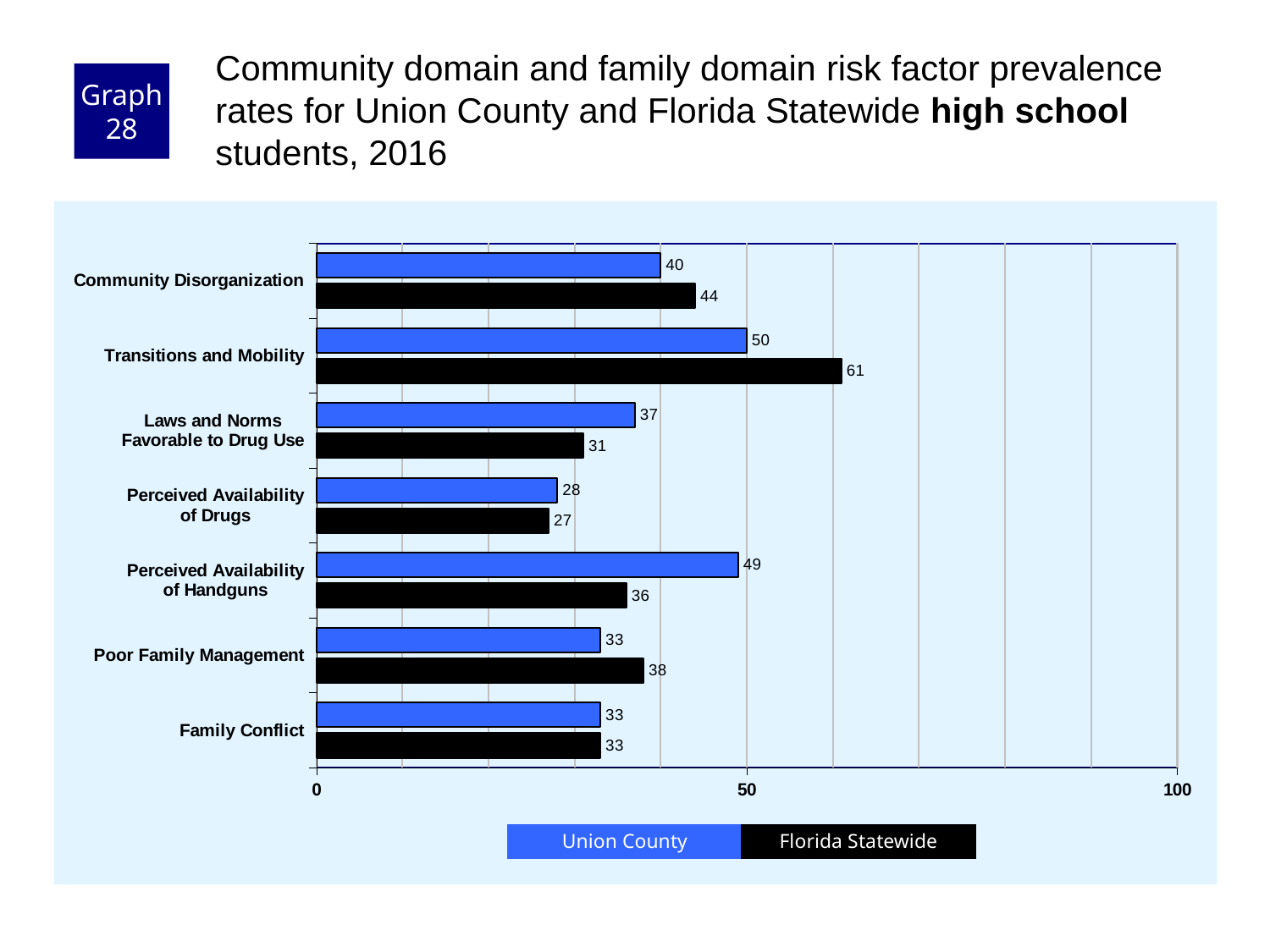
What is the difference between the Florida Statewide and Union County values for Transitions and Mobility? 11 What is the Florida Statewide value for Perceived Availability of Handguns? 36 What is the difference between the Union County and Florida Statewide values for Perceived Availability of Handguns? 13 What kind of chart is shown on the slide? bar chart Which risk factor has the lowest Union County value? Perceived Availability of Drugs Which is larger for Community Disorganization: the Union County value or the Florida Statewide value? Florida Statewide How many series does the legend list? 2 How many risk factor categories are shown on the chart? 7 Is the Florida Statewide value for Transitions and Mobility greater or less than 50? greater What is the Union County value for Transitions and Mobility? 50 Which risk factor has the highest Florida Statewide value? Transitions and Mobility What is the Florida Statewide value for Poor Family Management? 38